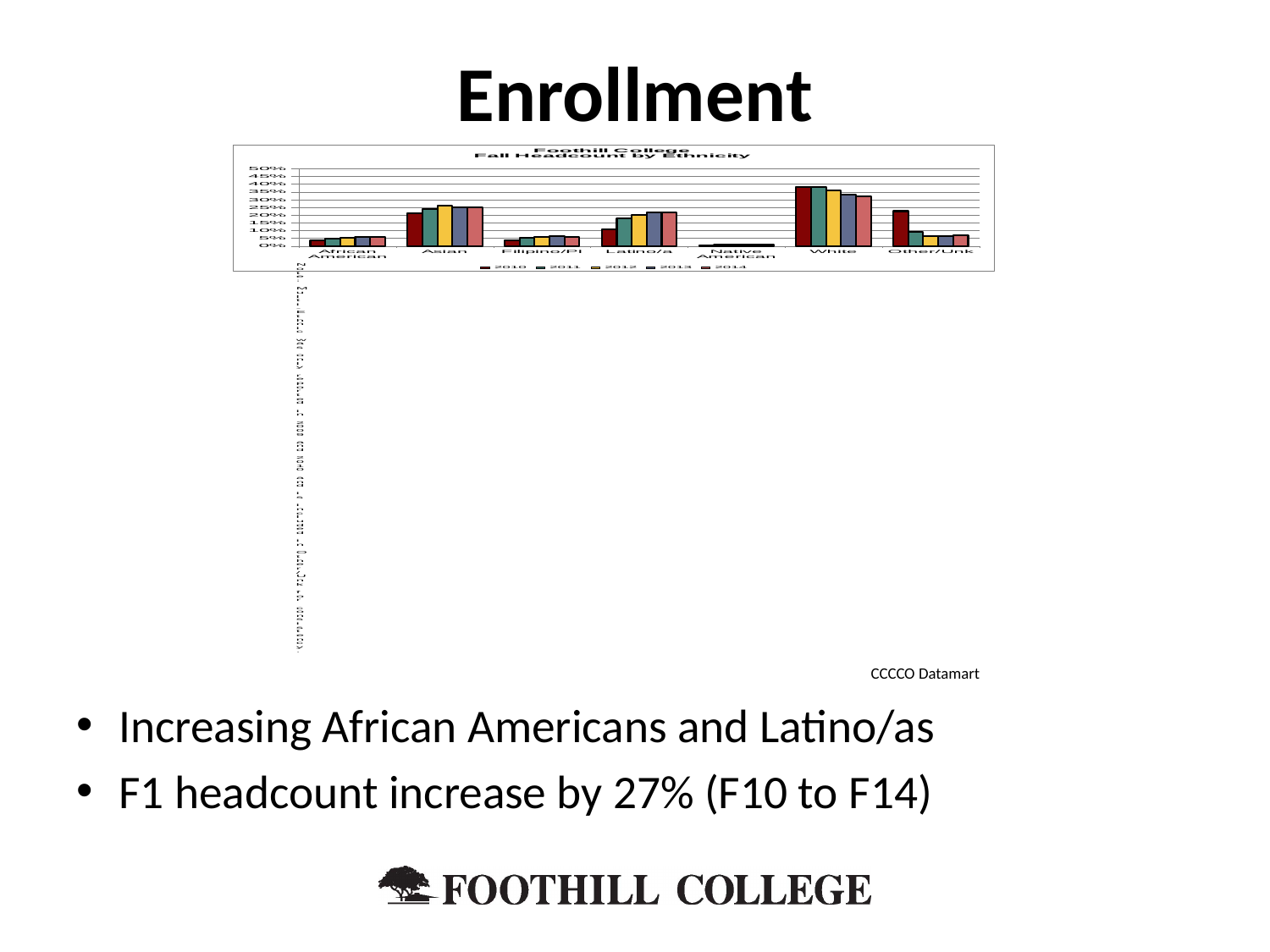
What type of chart is shown on the slide? bar chart Do the values for Latino/a rise or fall from 2010 to 2014? rise What is the title of the chart? Foothill College Fall Headcount by Ethnicity In 2010, which is larger: the value for Asian or the value for Latino/a? Asian Is the 2010 value for White greater or less than 30%? greater How many series (years) does the chart legend list? 5 Which ethnicity category has the highest headcount share in the chart? White Is the 2010 value for Latino/a greater or less than 15%? less Which ethnicity category has the lowest headcount share in the chart? Native American How many ethnicity categories are shown on the x axis of the chart? 7 Is the 2010 value for Other/Unk greater or less than 15%? greater Do the values for White rise or fall from 2010 to 2014? fall